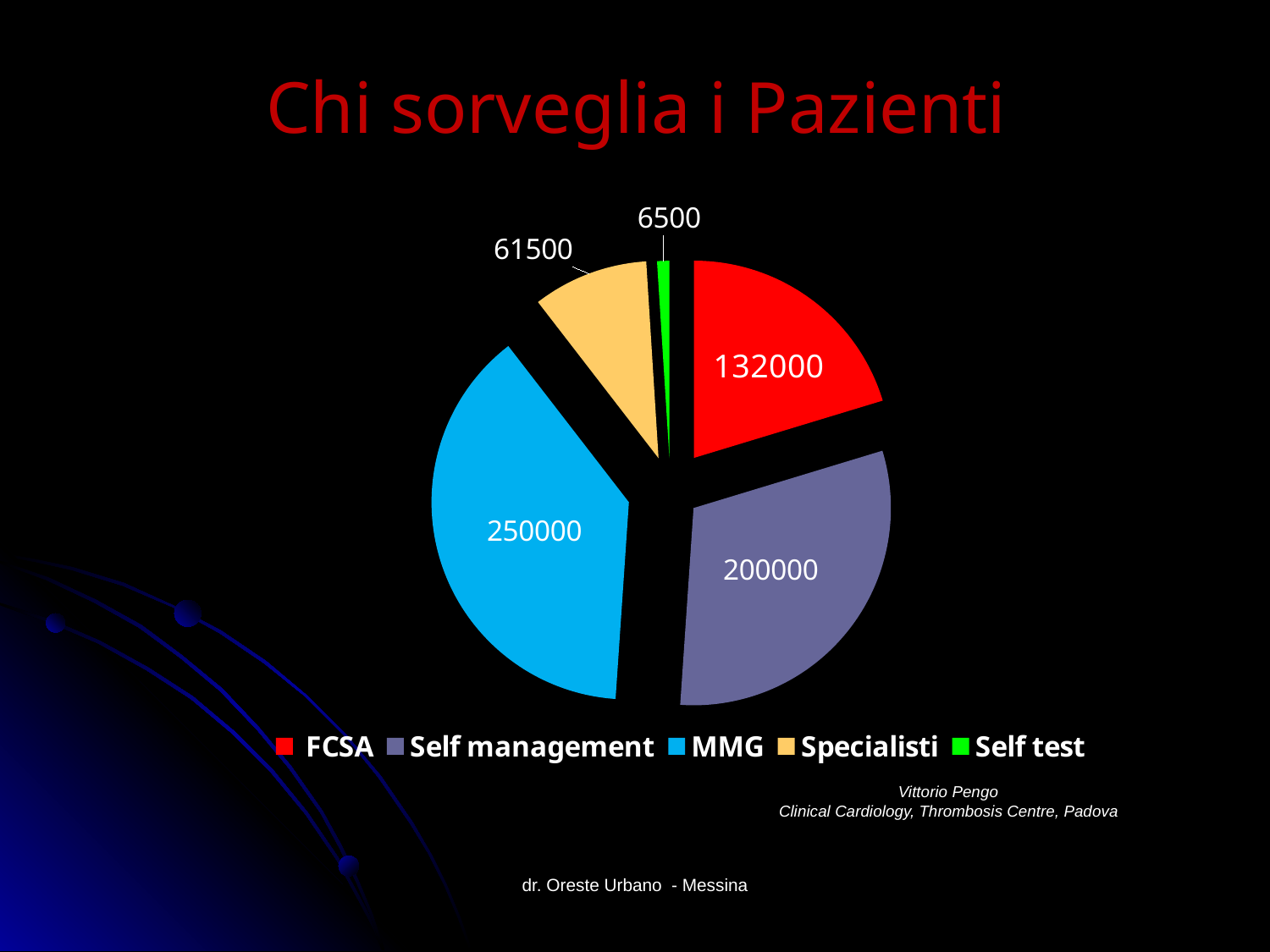
What is the difference between the Specialisti value and the Self test value? 55000 Which category has the smallest slice of the pie? Self test Which category has the largest slice of the pie? MMG What value is shown for the MMG slice of the pie chart? 250000 How many categories does the pie chart show? 5 What type of chart is shown on the slide? Pie chart What share of the total does the Self test slice represent? 1% What value is shown for the FCSA slice? 132000 What value is shown for the Specialisti slice? 61500 What value is shown for the Self test slice? 6500 Which is larger, the FCSA value or the Self management value? Self management What is the difference between the MMG value and the Self management value? 50000